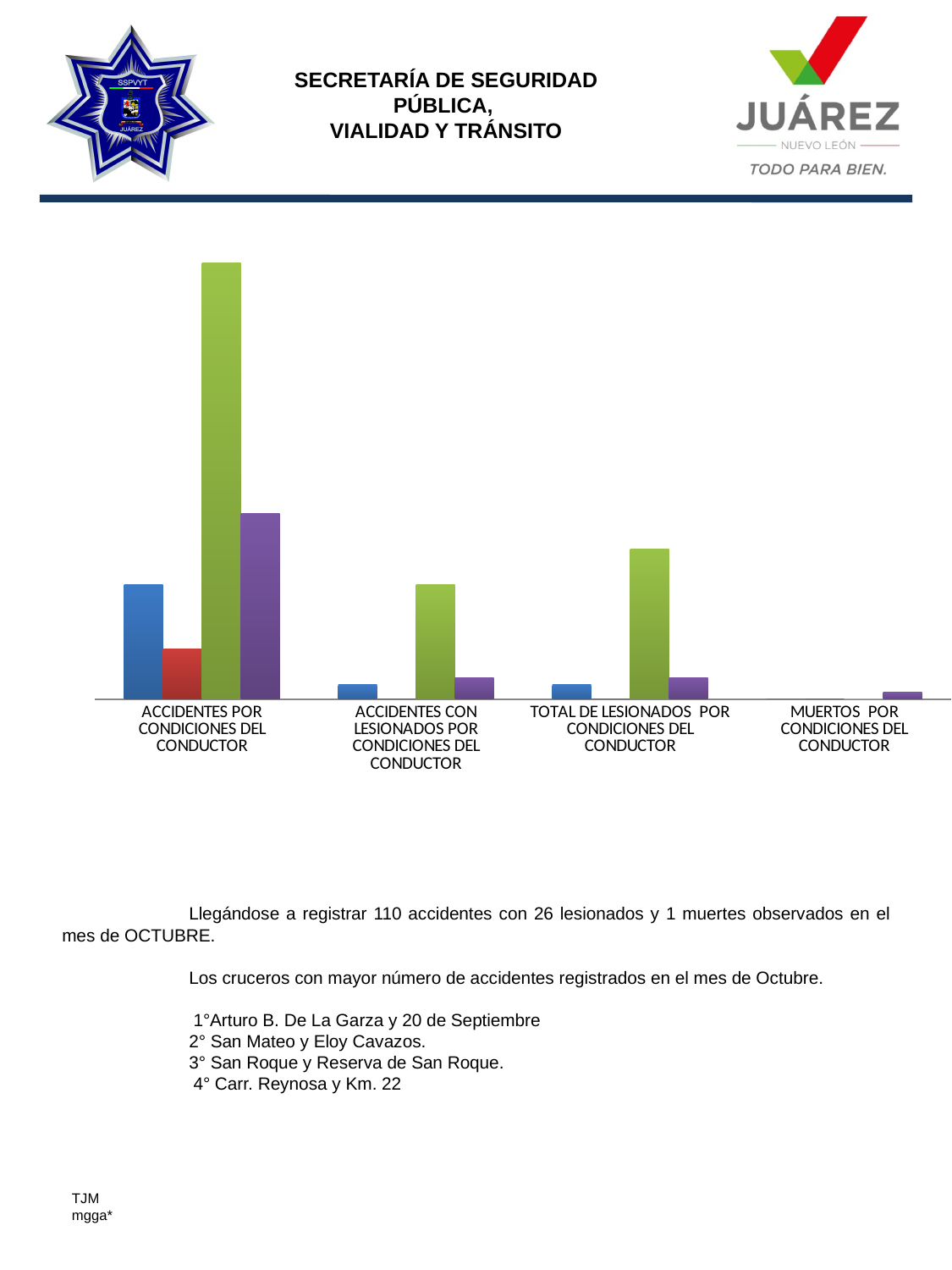
In the ACCIDENTES POR CONDICIONES DEL CONDUCTOR category, is the green bar or the purple bar taller? green Which category has the tallest bar in the chart? ACCIDENTES POR CONDICIONES DEL CONDUCTOR In the ACCIDENTES POR CONDICIONES DEL CONDUCTOR category, is the blue bar or the red bar taller? blue How many categories are shown along the x axis of the chart? 4 Which category is the only one with a red bar? ACCIDENTES POR CONDICIONES DEL CONDUCTOR What kind of chart is shown on the slide? bar chart Which category has the shortest bars in the chart? MUERTOS POR CONDICIONES DEL CONDUCTOR Is the green bar taller for ACCIDENTES CON LESIONADOS POR CONDICIONES DEL CONDUCTOR or for TOTAL DE LESIONADOS POR CONDICIONES DEL CONDUCTOR? TOTAL DE LESIONADOS POR CONDICIONES DEL CONDUCTOR Does the chart display a legend? No